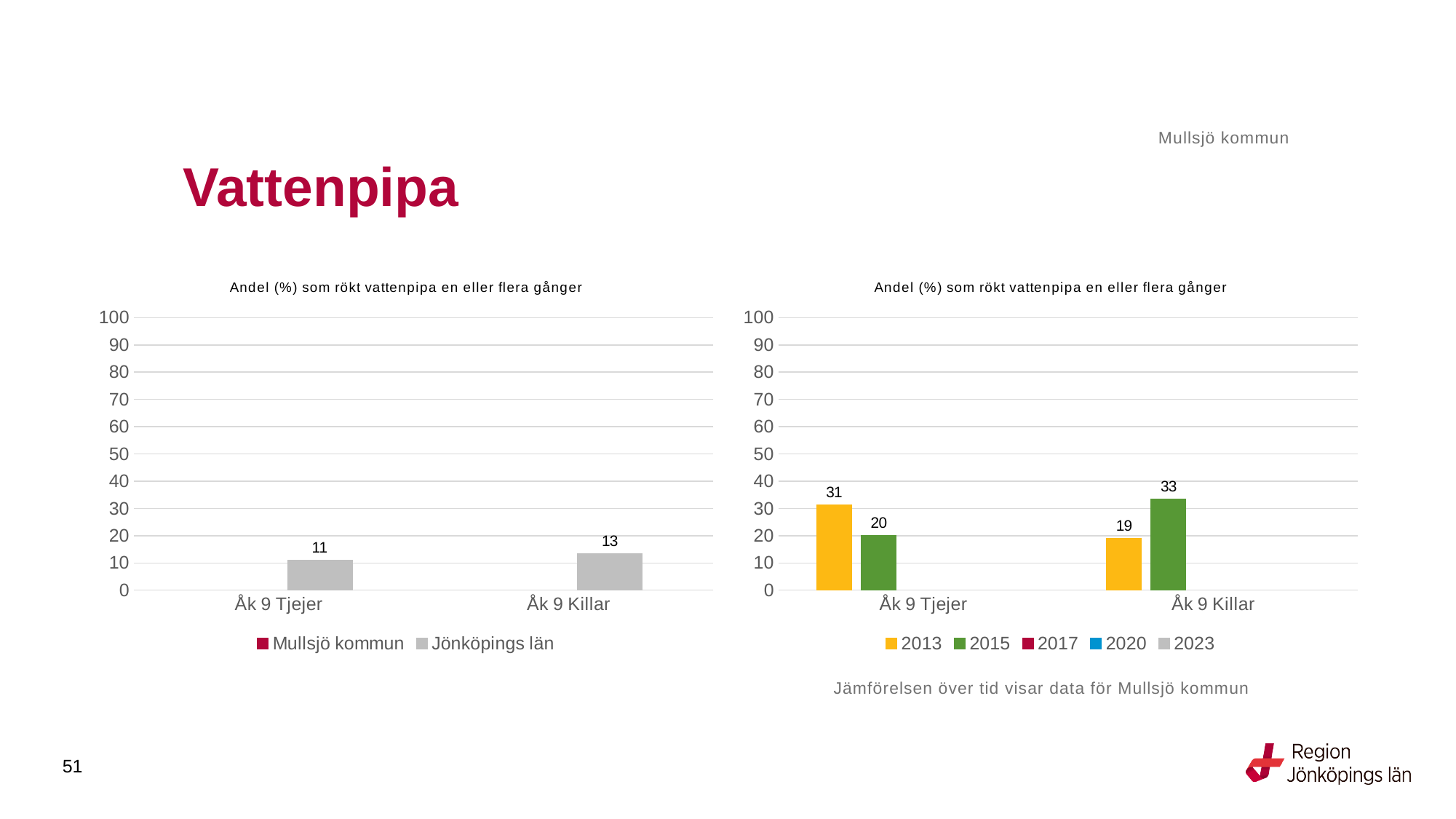
What kind of chart is the right chart? Bar chart In the left chart, how many series does the legend list? 2 In the right chart, how many series does the legend list? 5 In the left chart, what is the difference between the Jönköpings län values for Åk 9 Killar and Åk 9 Tjejer? 2 In the right chart, what is the difference between the 2015 and 2013 values for Åk 9 Killar? 14 In the left chart, what is the value for Jönköpings län for Åk 9 Tjejer? 11 In the left chart, what is the value for Jönköpings län for Åk 9 Killar? 13 In the right chart, is the 2013 value for Åk 9 Tjejer greater or less than 30? greater In the right chart, what is the value for 2013 for Åk 9 Tjejer? 31 In the right chart, what is the value for 2013 for Åk 9 Killar? 19 In the right chart, what is the value for 2015 for Åk 9 Killar? 33 In the right chart, which is larger for Åk 9 Tjejer: the 2013 value or the 2015 value? 2013